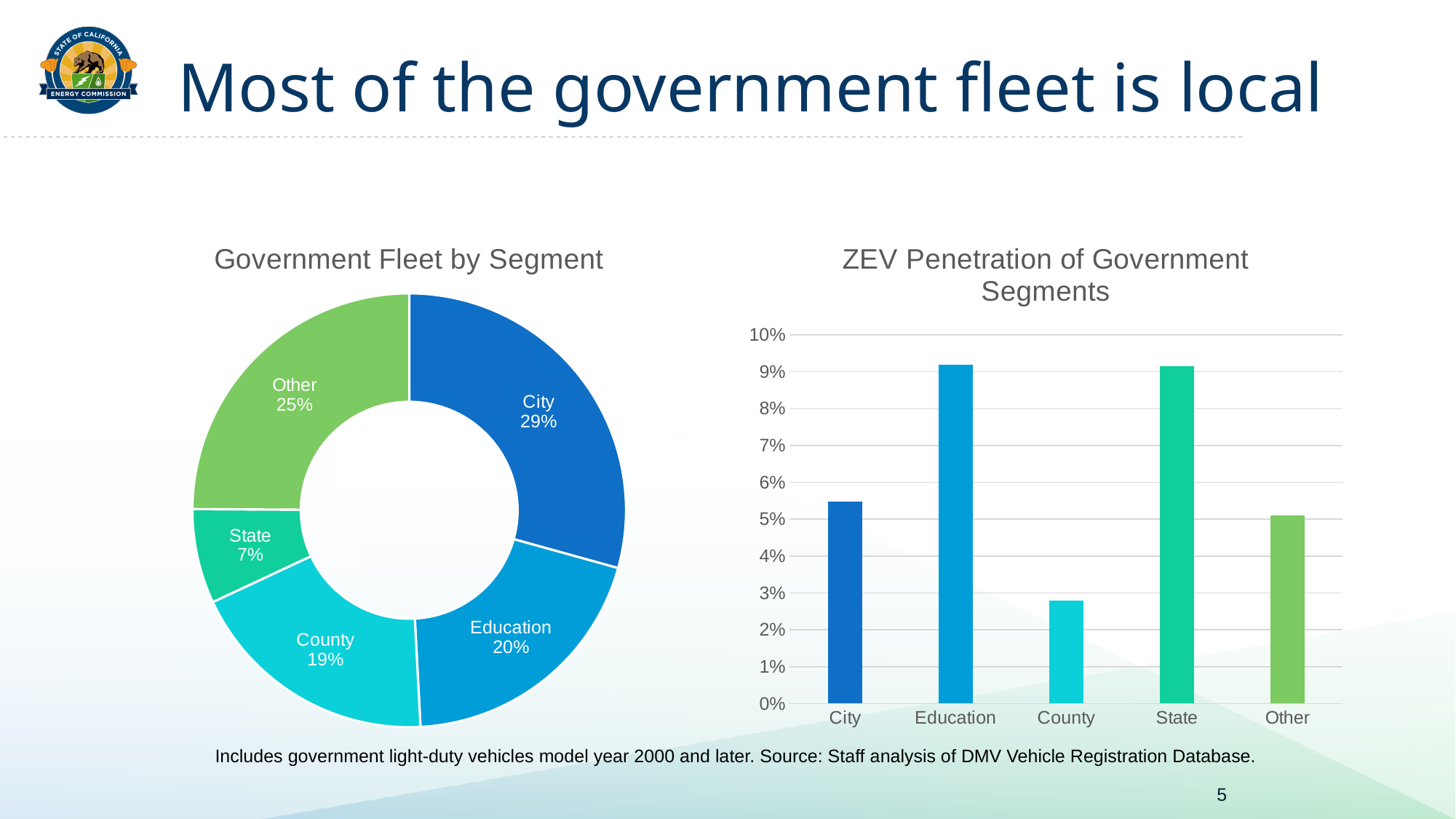
In the 'Government Fleet by Segment' chart, what is the difference between the Other share and the County share? 6% In the 'Government Fleet by Segment' chart, which segment has the smallest share? State In the 'Government Fleet by Segment' chart, how many segments are shown? 5 In the 'Government Fleet by Segment' chart, what share of the fleet is City? 29% In the 'Government Fleet by Segment' chart, what share of the fleet is State? 7% What kind of chart is 'Government Fleet by Segment'? Pie (donut) chart In the 'Government Fleet by Segment' chart, which segment has the largest share? City In the 'ZEV Penetration of Government Segments' chart, which segment has the lowest ZEV penetration? County In the 'ZEV Penetration of Government Segments' chart, which is larger, the value for City or the value for County? City What kind of chart is 'ZEV Penetration of Government Segments'? Bar chart